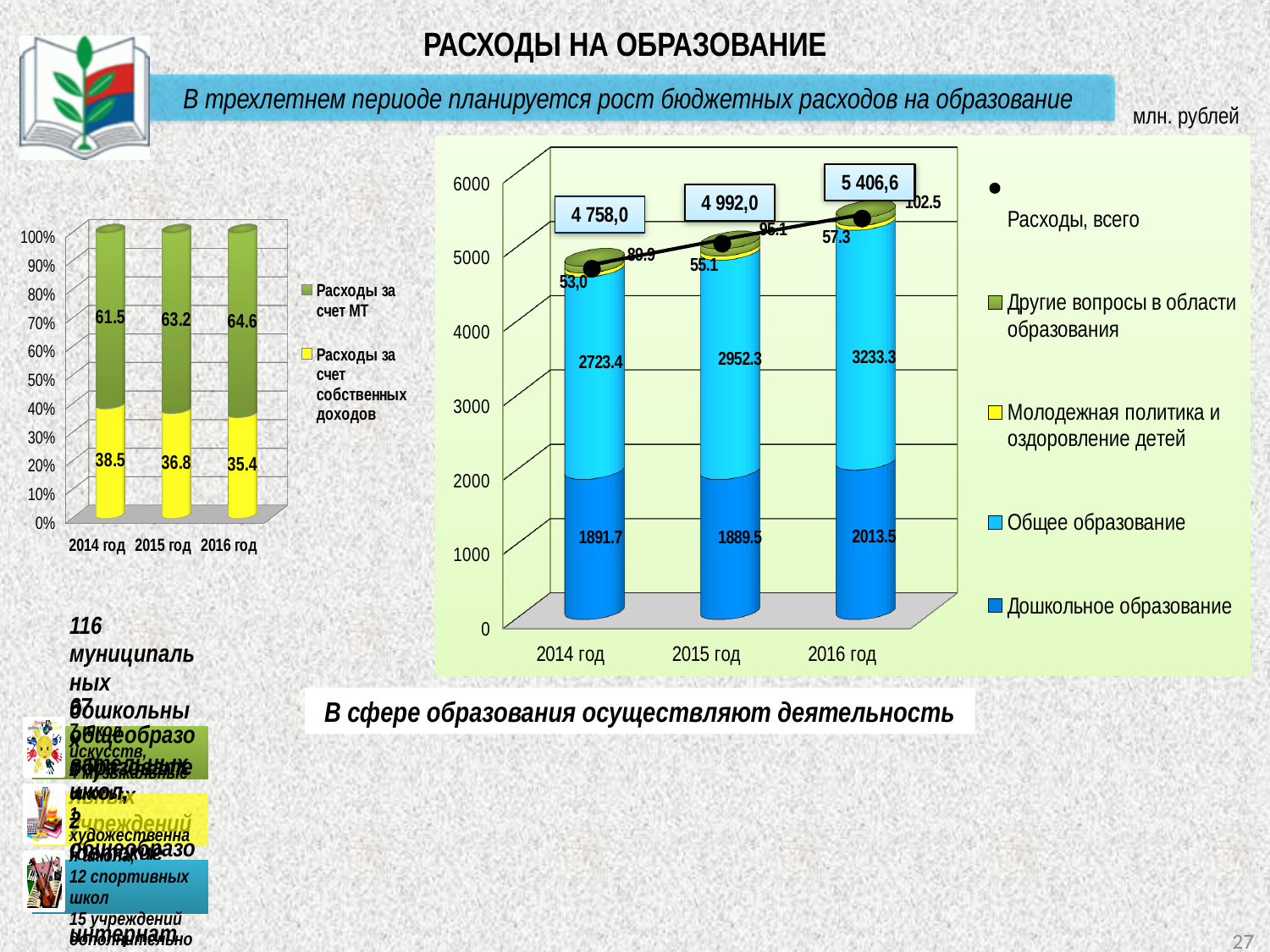
On the right chart, what is the value for Молодежная политика и оздоровление детей in 2015 год? 55.1 On the right chart, what is the total Расходы, всего for 2016 год? 5 406,6 On the right chart, what is the difference between Общее образование in 2015 год and 2014 год? 228.9 On the left chart, what is the value for Расходы за счет МТ in 2015 год? 63.2 On the right chart, does the Расходы, всего line rise or fall from 2014 год to 2016 год? rise What kind of chart is the left chart? Stacked bar chart On the right chart, what is the value for Общее образование in 2016 год? 3233.3 On the right chart, how many series does the legend list? 5 On the left chart, is the value for Расходы за счет МТ in 2014 год larger than the value for Расходы за счет собственных доходов in 2014 год? Yes On the right chart, what is the value for Дошкольное образование in 2014 год? 1891.7 On the left chart, which year has the lowest value for Расходы за счет собственных доходов? 2016 год On the right chart, which year has the highest value for Общее образование? 2016 год